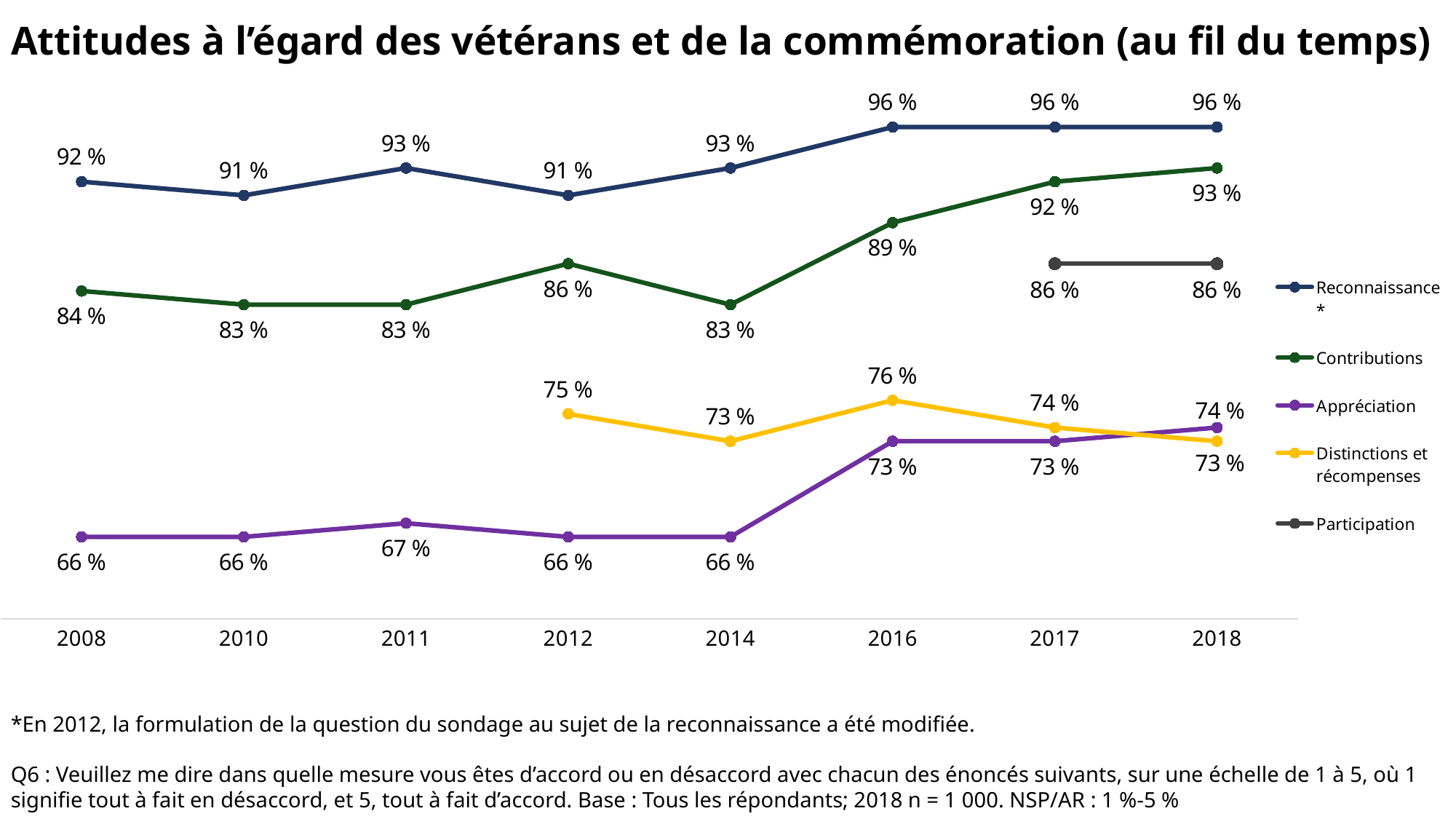
What is the value for Appréciation in 2011? 67 % In which year is the Contributions series at its highest? 2018 In 2018, which is larger: Appréciation or Distinctions et récompenses? Appréciation What kind of chart is shown on the slide? Line chart What is the value for Contributions in 2016? 89 % What is the value for Reconnaissance in 2008? 92 % What is the value for Participation in 2017? 86 % What is the difference between Contributions in 2018 and Contributions in 2008? 9 % How many years are shown on the x axis? 8 What is the value for Distinctions et récompenses in 2016? 76 % In which year is the Distinctions et récompenses series at its highest? 2016 How many series does the legend list? 5